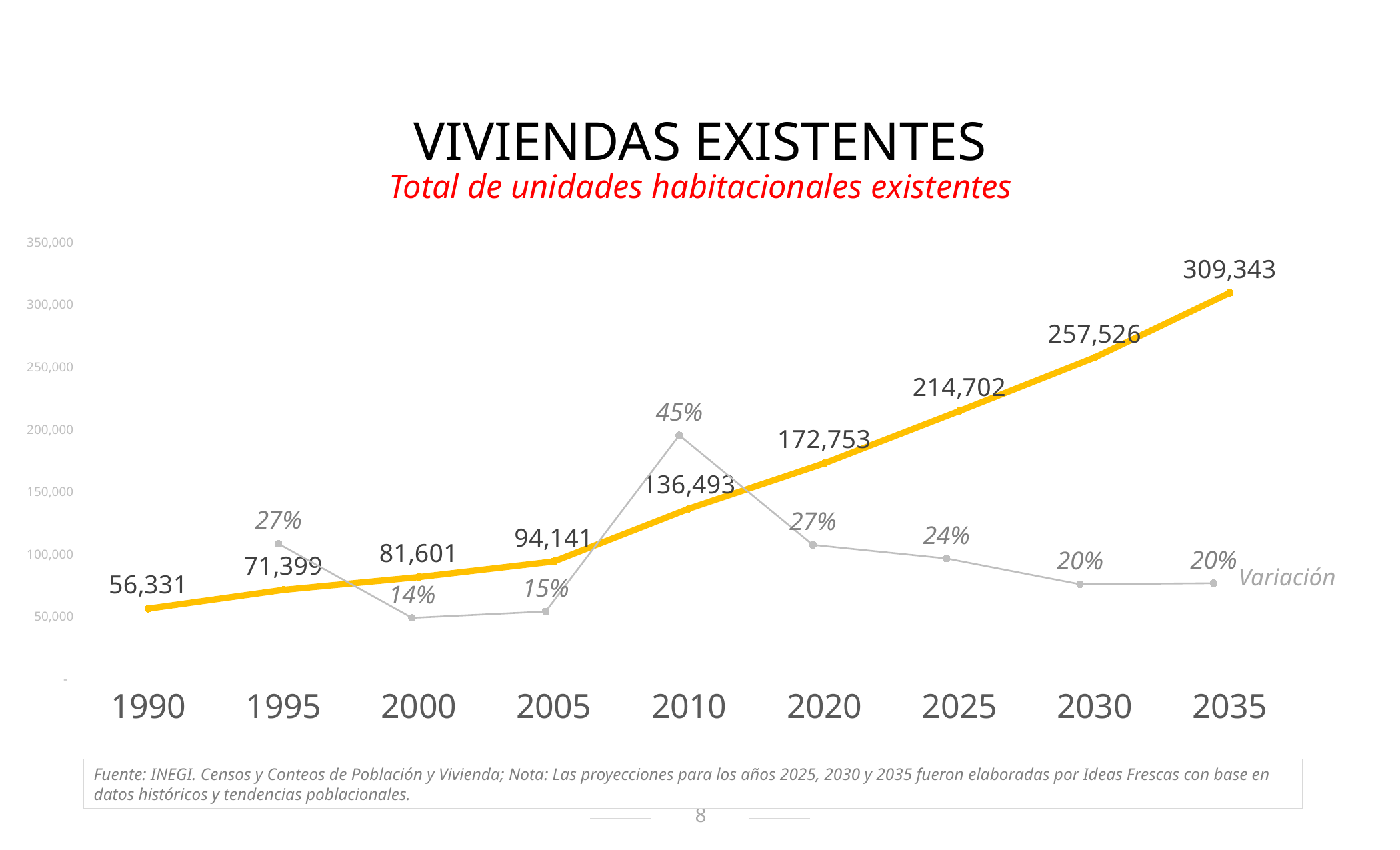
Which is larger, the Variación for 1995 or the Variación for 2025? 1995 How many years are shown on the x axis? 9 In which year is the Variación percentage the lowest? 2000 Which year has the highest number of existing housing units? 2035 What is the Variación percentage shown for 2010? 45% What is the red subtitle under the chart title? Total de unidades habitacionales existentes What kind of chart is shown on the slide? Line chart What is the number of existing housing units shown for 2010? 136,493 What value is labelled for 1990 on the yellow line? 56,331 Is the value for 2020 greater or less than 150,000? greater What is the difference between the housing unit values for 2035 and 2030? 51,817 Do the housing unit values rise or fall from 1990 to 2035? Rise